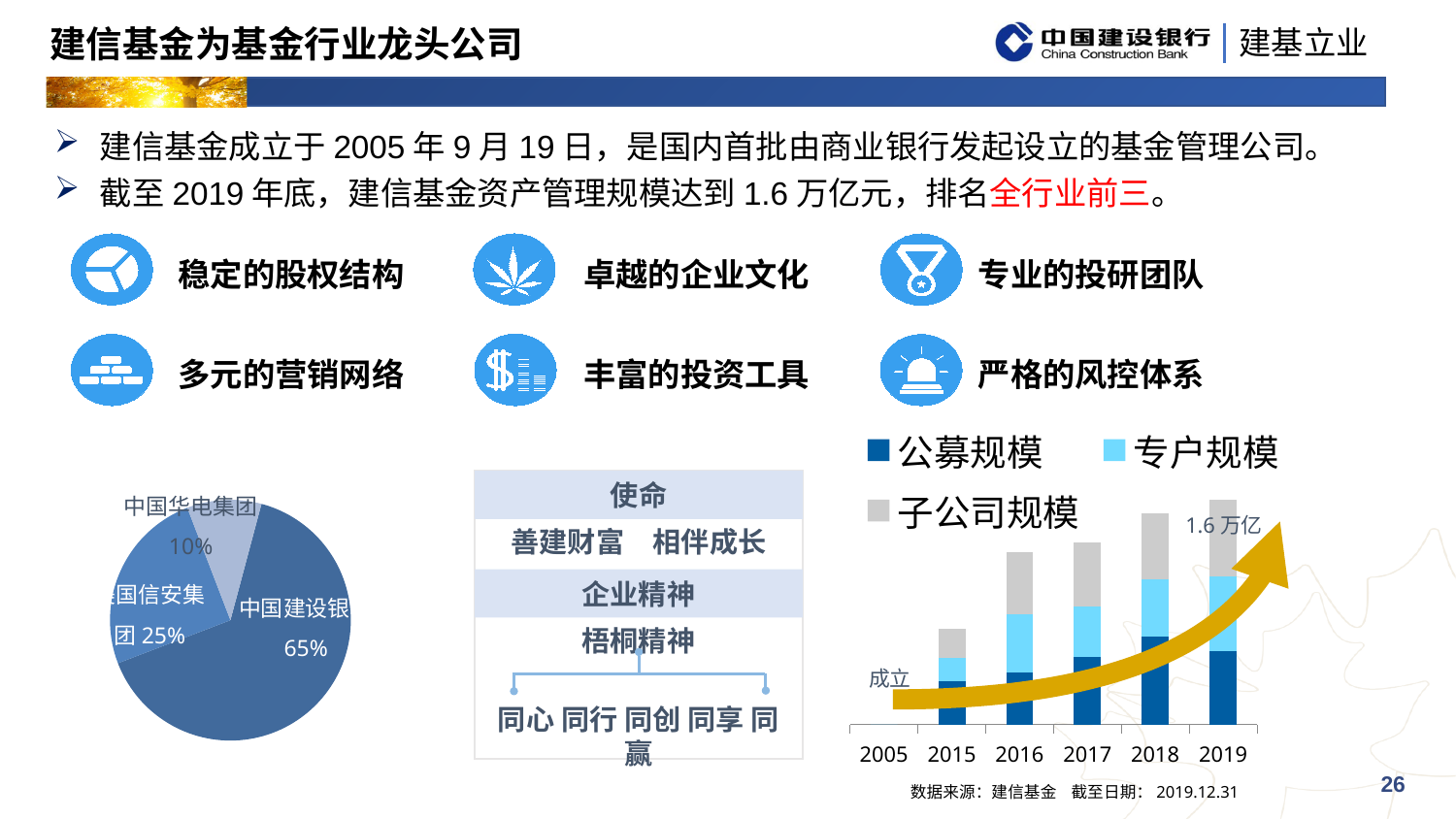
What kind of chart is the chart on the left of the slide? pie chart In the bar chart on the right, what value is labeled on the 2019 bar? 1.6 万亿 In the pie chart on the left, what share does 中国建设银行 hold? 65% In the bar chart on the right, which year has the tallest bar? 2019 How many series does the legend of the bar chart on the right list? 3 In the pie chart on the left, which slice is the largest? 中国建设银行 In the bar chart on the right, do the bar totals rise or fall from 2015 to 2019? rise How many slices does the pie chart on the left have? 3 In the bar chart on the right, which bar is taller, 2016 or 2018? 2018 In the pie chart on the left, what share does 中国华电集团 hold? 10% In the pie chart on the left, which slice is the smallest? 中国华电集团 What kind of chart is the chart on the right of the slide? bar chart